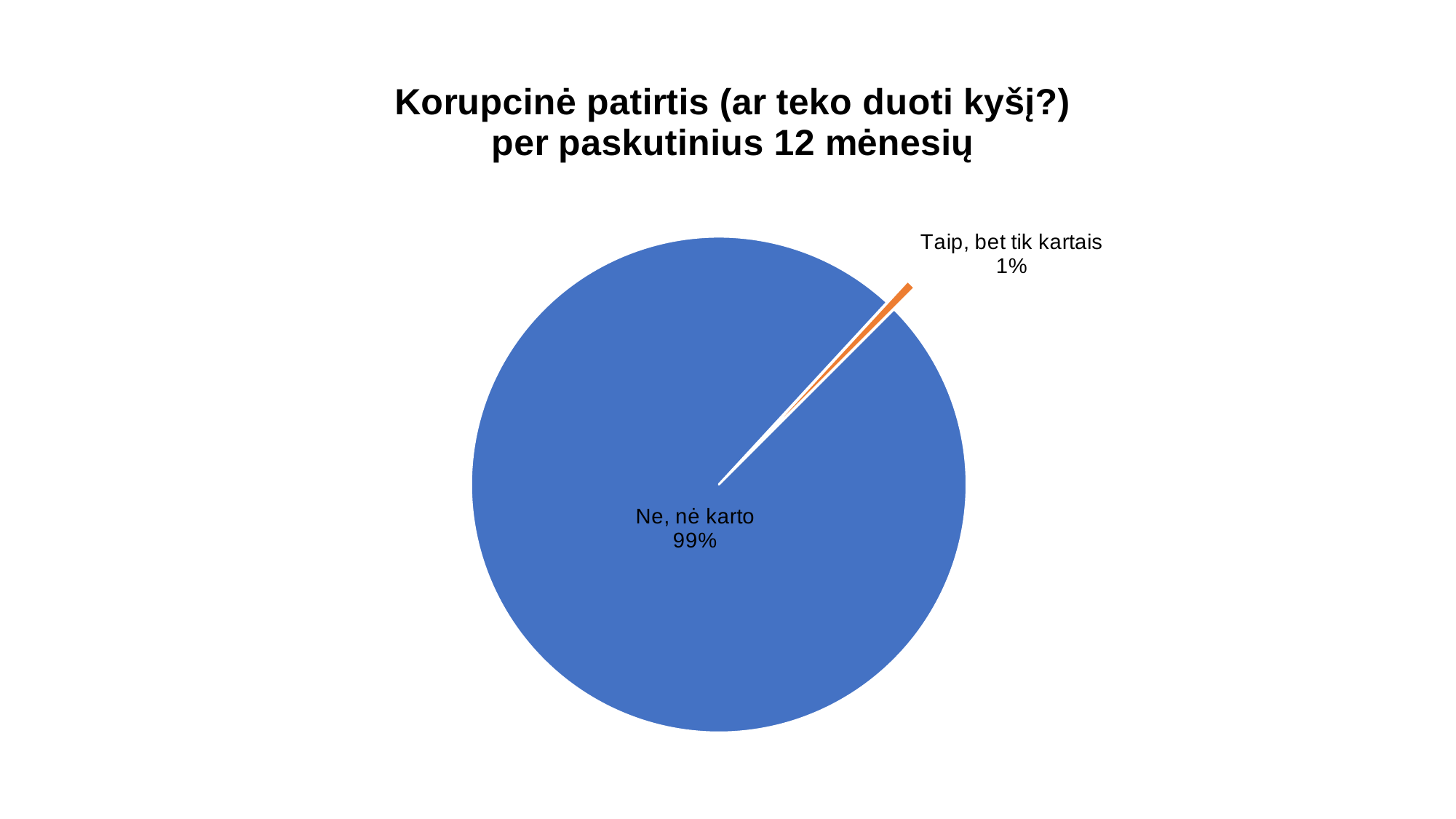
What share of the pie does "Taip, bet tik kartais" represent? 1% What is the total of the two percentages shown on the pie chart? 100% What share of the pie does "Ne, nė karto" represent? 99% What is the title of the chart? Korupcinė patirtis (ar teko duoti kyšį?) per paskutinius 12 mėnesių What colour is the slice for "Taip, bet tik kartais"? Orange What is the difference in percentage points between "Ne, nė karto" and "Taip, bet tik kartais"? 98 percentage points How many slices does the pie chart have? 2 Which category has the smallest slice of the pie? Taip, bet tik kartais Which category has the largest slice of the pie? Ne, nė karto What kind of chart is shown on the slide? Pie chart Which is larger: the slice for "Ne, nė karto" or the slice for "Taip, bet tik kartais"? Ne, nė karto